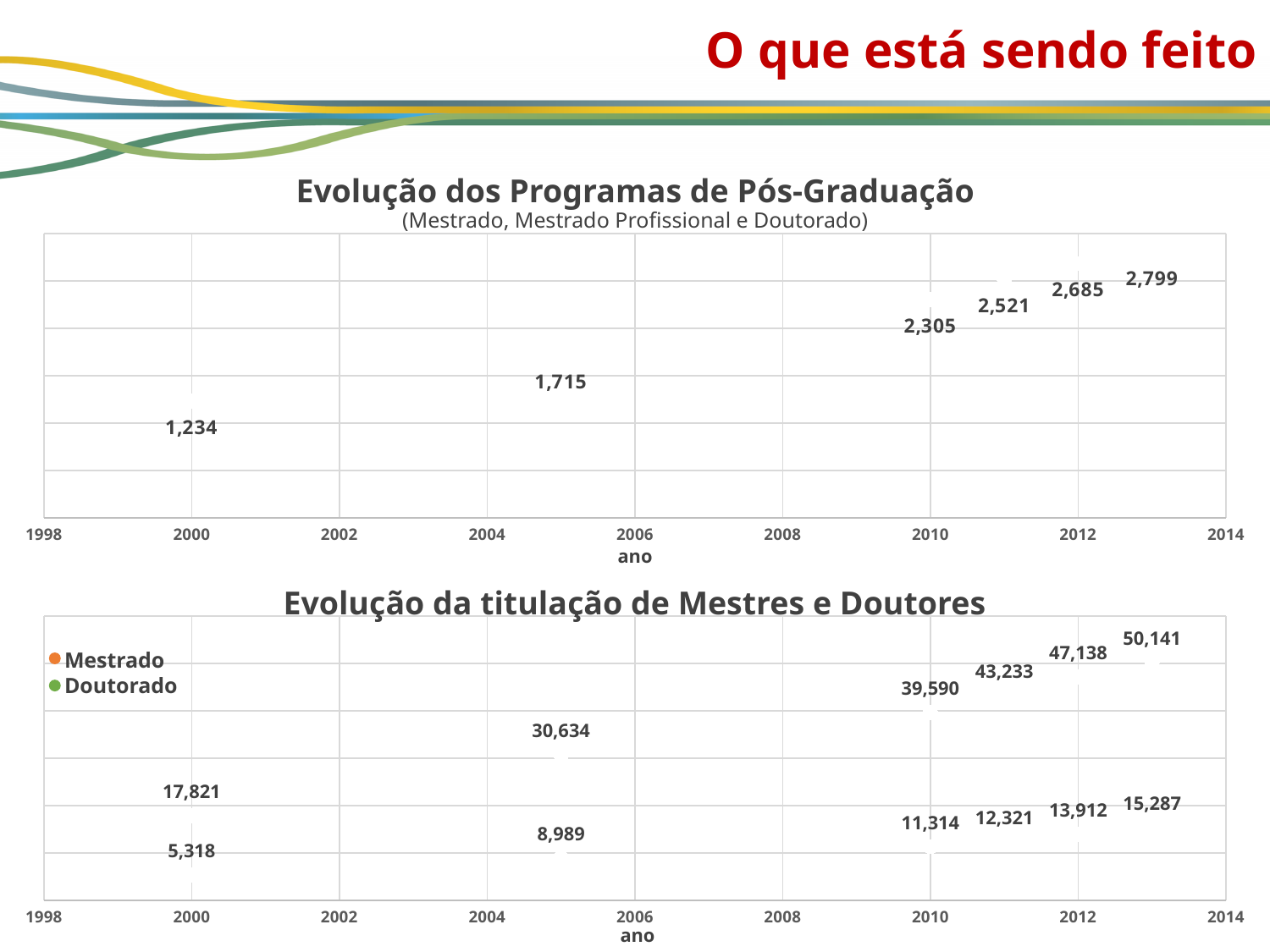
In the bottom chart 'Evolução da titulação de Mestres e Doutores', which series has the lower value in 2010, Mestrado or Doutorado? Doutorado In the top chart 'Evolução dos Programas de Pós-Graduação', what is the value for the year 2010? 2,305 In the top chart 'Evolução dos Programas de Pós-Graduação', do the values rise or fall over the years? rise In the bottom chart 'Evolução da titulação de Mestres e Doutores', what is the Mestrado value for 2013? 50,141 In the top chart 'Evolução dos Programas de Pós-Graduação', which year has the highest value? 2013 In the bottom chart 'Evolução da titulação de Mestres e Doutores', what is the Doutorado value for 2000? 5,318 In the top chart 'Evolução dos Programas de Pós-Graduação', what is the difference between the 2012 value and the 2010 value? 380 In the top chart 'Evolução dos Programas de Pós-Graduação', how many data points are plotted? 6 In the bottom chart 'Evolução da titulação de Mestres e Doutores', how many series does the legend list? 2 In the bottom chart 'Evolução da titulação de Mestres e Doutores', what is the difference between the Mestrado and Doutorado values in 2012? 33,226 In the bottom chart 'Evolução da titulação de Mestres e Doutores', what colour is used for the Mestrado series in the legend? orange In the top chart 'Evolução dos Programas de Pós-Graduação', what is the value for the year 2000? 1,234